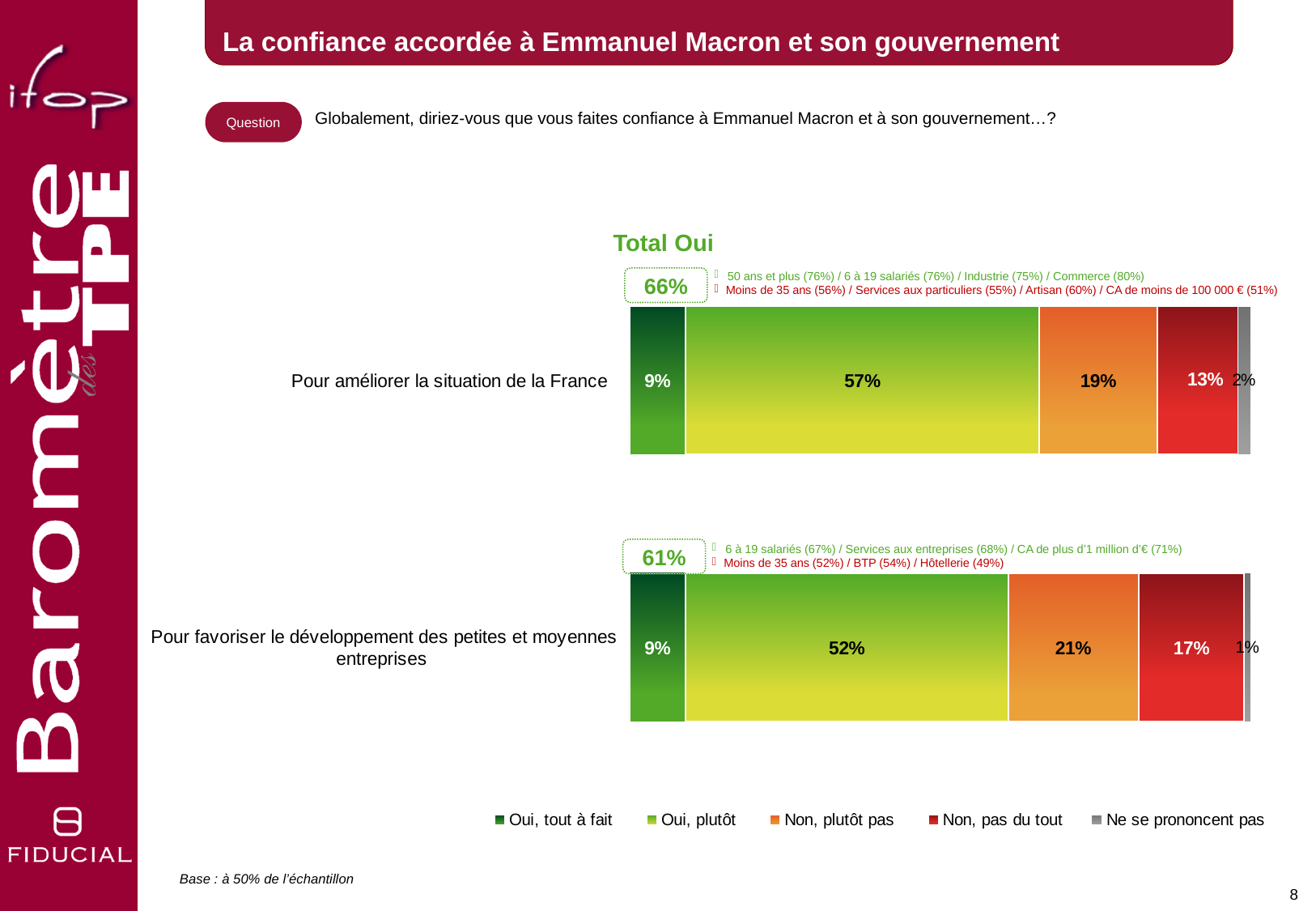
Which series has the highest value for "Pour favoriser le développement des petites et moyennes entreprises"? Oui, plutôt How many categories are plotted in the chart? 2 What is the value for "Oui, plutôt" for "Pour améliorer la situation de la France"? 57% What kind of chart is shown on the slide? Stacked bar chart Which category has the larger "Non, plutôt pas" value? Pour favoriser le développement des petites et moyennes entreprises What is the value for "Non, pas du tout" for "Pour favoriser le développement des petites et moyennes entreprises"? 17% What is the "Total Oui" shown for "Pour favoriser le développement des petites et moyennes entreprises"? 61% What is the combined value of "Oui, tout à fait" and "Oui, plutôt" for "Pour améliorer la situation de la France"? 66% What is the value for "Non, plutôt pas" for "Pour améliorer la situation de la France"? 19% What is the difference between the "Oui, plutôt" values for "Pour améliorer la situation de la France" and "Pour favoriser le développement des petites et moyennes entreprises"? 5% Which series has the lowest value for "Pour améliorer la situation de la France"? Ne se prononcent pas How many series does the legend list? 5